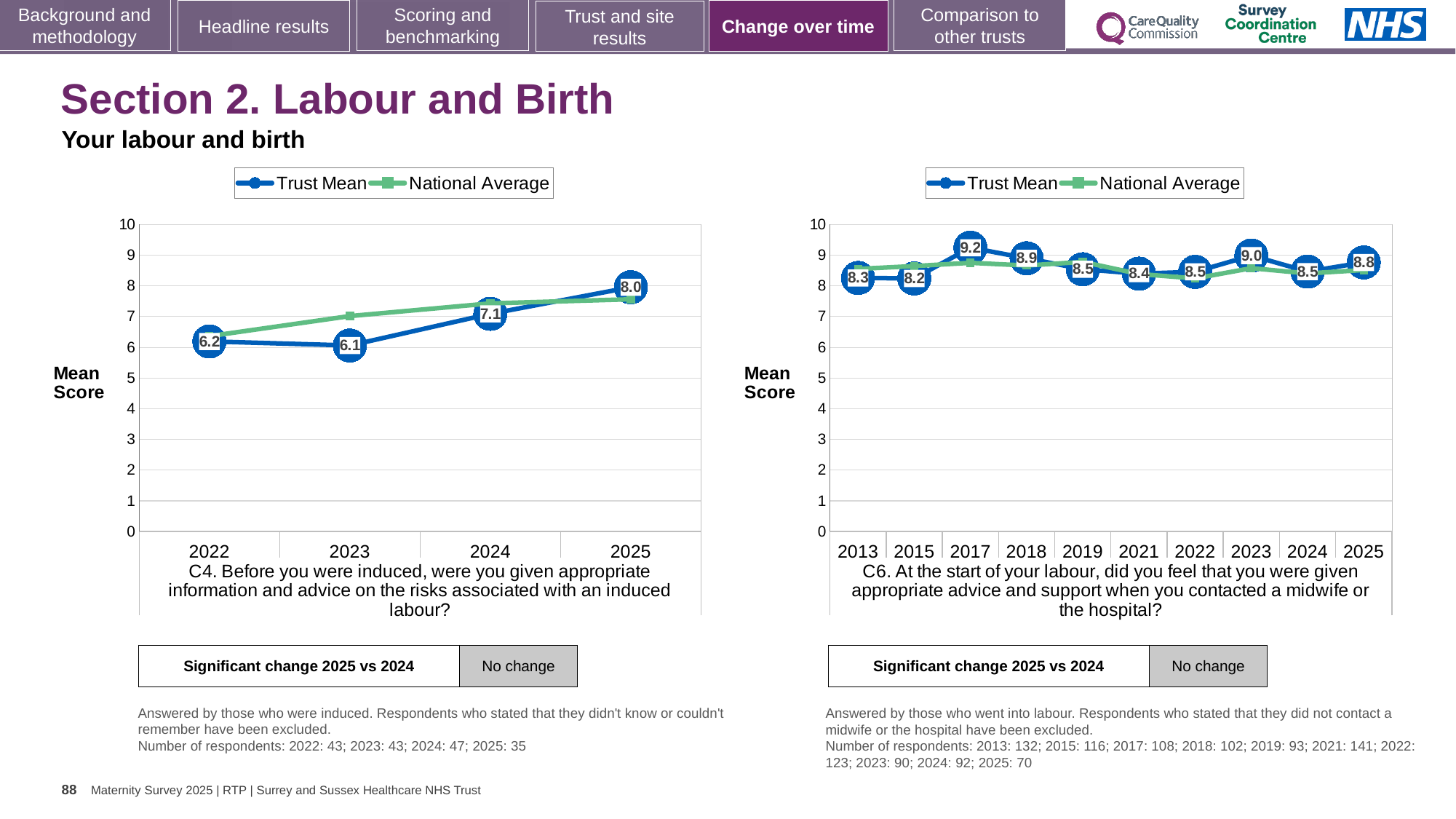
In the right chart (C6), which is larger, the Trust Mean score for 2023 or for 2024? 2023 In the left chart (C4), what is the Trust Mean score for 2023? 6.1 In the right chart (C6), which year has the highest Trust Mean score? 2017 In the left chart (C4), how many years are shown on the x axis? 4 In the right chart (C6), how many years are shown on the x axis? 10 In the left chart (C4), which year has the lowest Trust Mean score? 2023 In the left chart (C4), what is the difference between the Trust Mean scores for 2025 and 2022? 1.8 How many series does the legend of the right chart (C6) list? 2 In the left chart (C4), which year has the highest Trust Mean score? 2025 In the right chart (C6), what is the Trust Mean score for 2025? 8.8 In the right chart (C6), what is the Trust Mean score for 2017? 9.2 In the left chart (C4), what is the Trust Mean score for 2025? 8.0